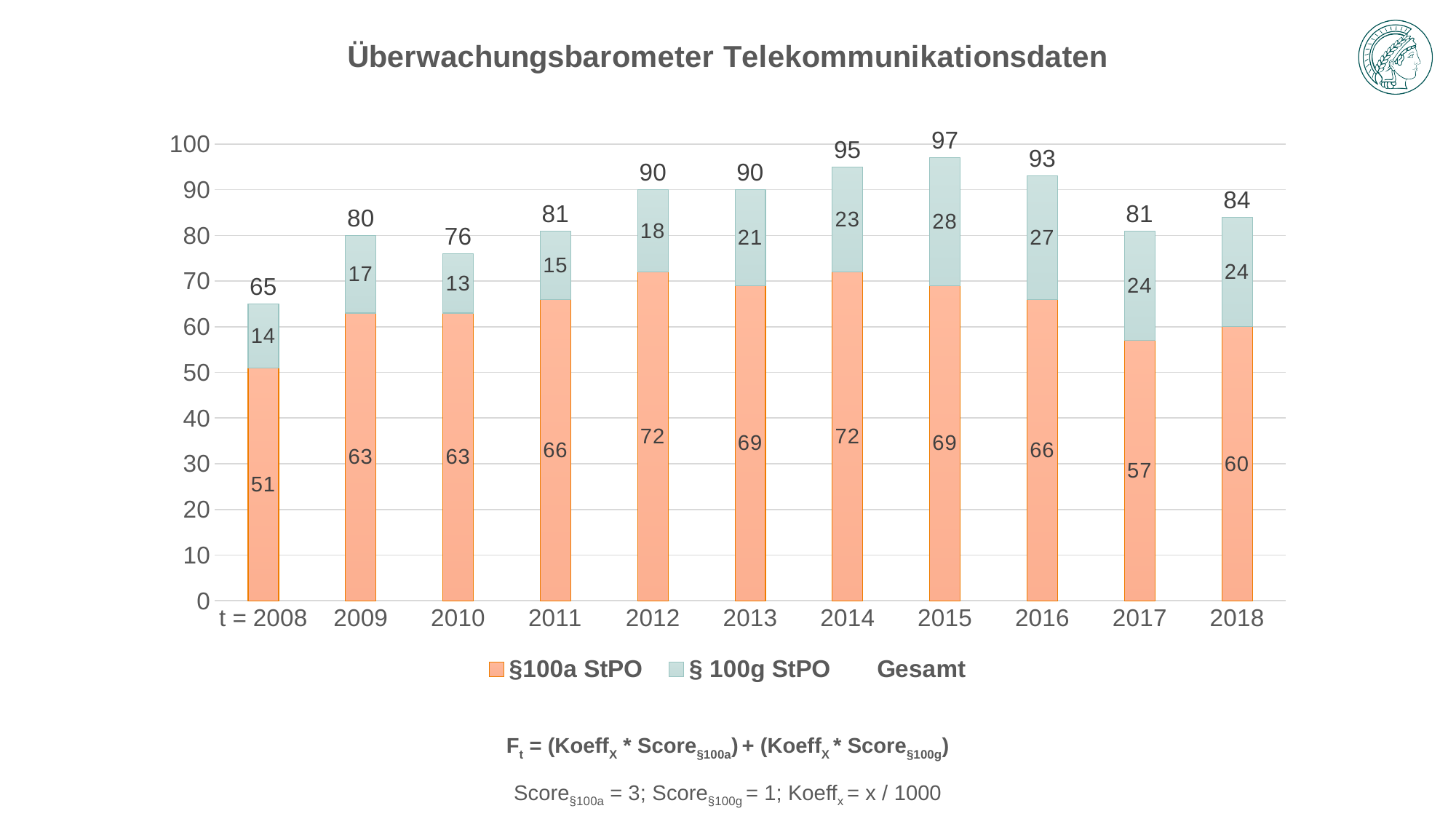
How many years are shown on the x axis? 11 What is the title of the chart? Überwachungsbarometer Telekommunikationsdaten How many series does the legend list? 3 What is the value of §100a StPO for 2012? 72 What kind of chart is shown? stacked bar chart What is the difference between the Gesamt totals for 2015 and 2018? 13 Which year has the highest Gesamt total? 2015 What is the total of the stacked bar for 2014? 95 What is the Gesamt (total) value for 2008? 65 What is the value of § 100g StPO for 2015? 28 Which year has the lowest § 100g StPO value? 2010 Which is larger, the §100a StPO value for 2017 or for 2018? 2018